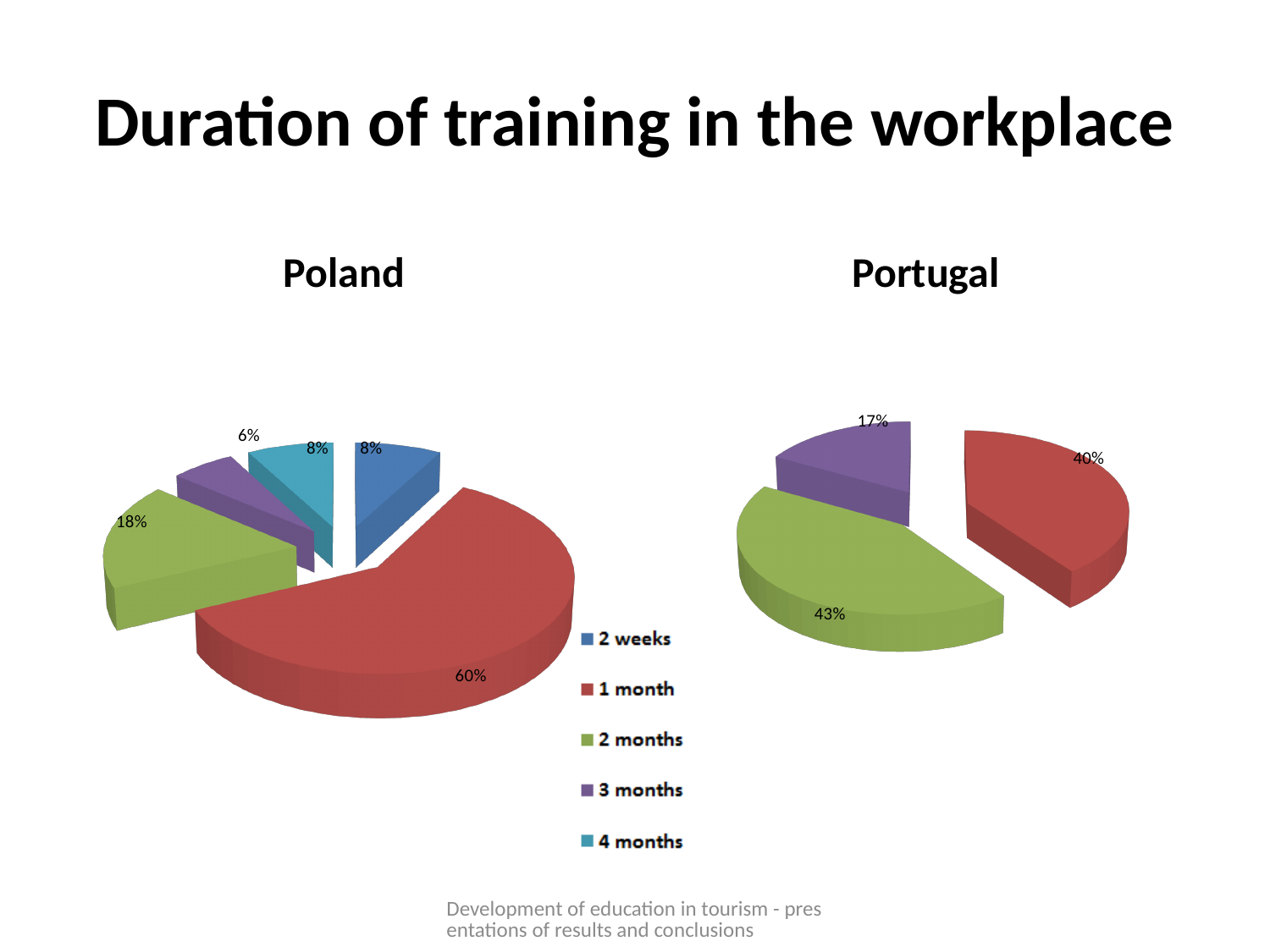
In the Poland pie chart, what share of respondents reported a training duration of 1 month? 60% In the Poland pie chart, what percentage corresponds to 2 months? 18% What type of chart is used for Poland and Portugal on this slide? Pie chart In the Portugal pie chart, what share is shown for 2 months? 43% How many entries does the legend list? 5 In the Portugal pie chart, is the share for 1 month or for 2 months larger? 2 months How many slices does the Portugal pie chart have? 3 In the Portugal pie chart, which training duration has the largest share? 2 months In the Poland pie chart, which training duration has the largest share? 1 month What is the difference between the 1 month share in Poland and the 1 month share in Portugal? 20 percentage points In the Poland pie chart, which training duration has the smallest share? 3 months In the Portugal pie chart, what percentage corresponds to 3 months? 17%